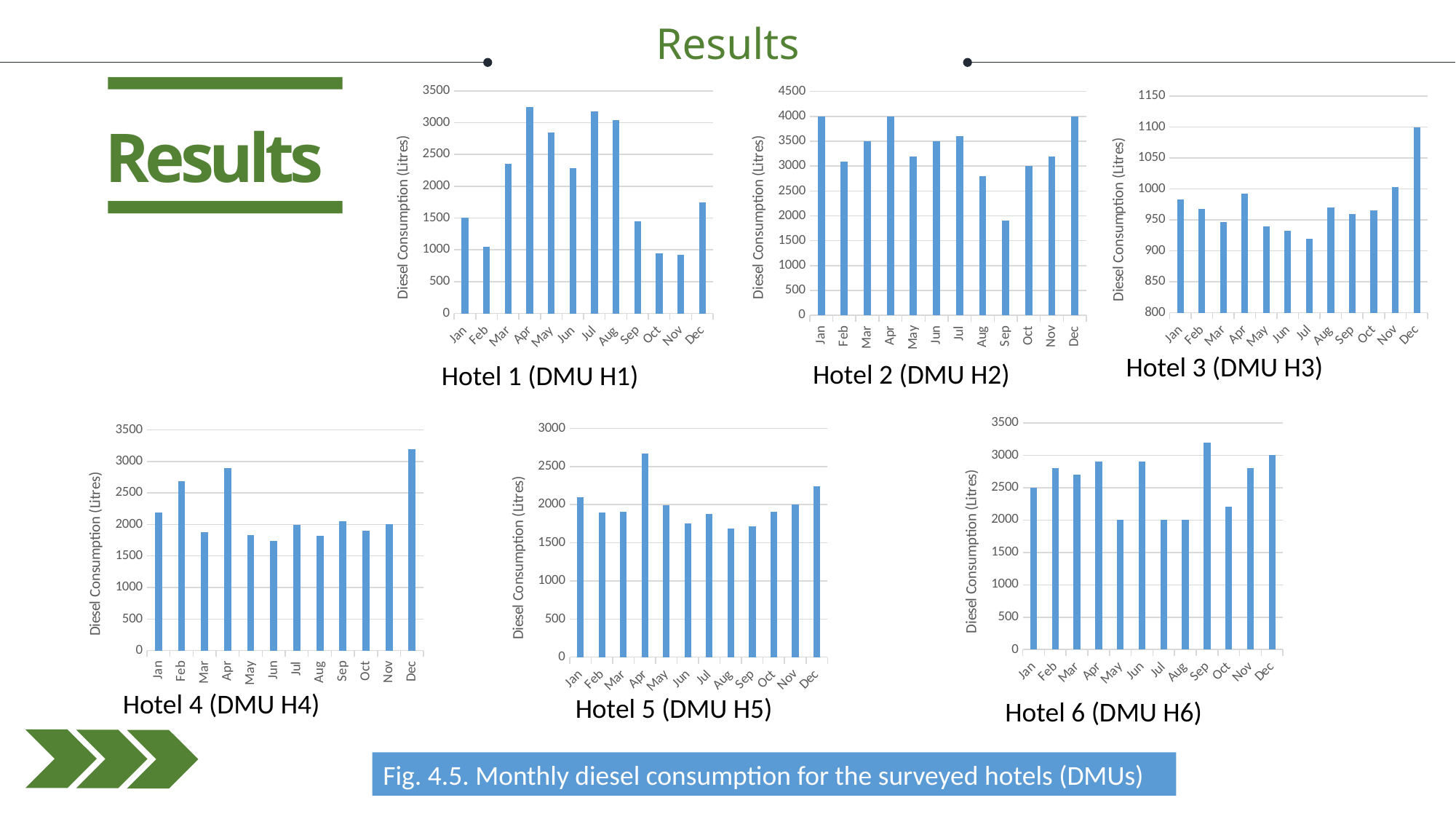
In the Hotel 1 (DMU H1) chart, which is larger, the value for Mar or the value for Oct? Mar In the Hotel 5 (DMU H5) chart, which month has the highest diesel consumption? Apr In the Hotel 4 (DMU H4) chart, which is larger, the value for Feb or the value for Mar? Feb In the Hotel 4 (DMU H4) chart, which month has the highest diesel consumption? Dec How many months are plotted on the x axis of the Hotel 5 (DMU H5) chart? 12 In the Hotel 2 (DMU H2) chart, is the value for Sep greater or less than 2000? less In the Hotel 6 (DMU H6) chart, which month has the highest diesel consumption? Sep In the Hotel 3 (DMU H3) chart, is the value for Dec greater or less than 1050? greater What kind of chart is used for Hotel 6 (DMU H6)? Bar chart In the Hotel 1 (DMU H1) chart, is the value for Apr greater or less than 3000? greater In the Hotel 2 (DMU H2) chart, which month has the lowest diesel consumption? Sep